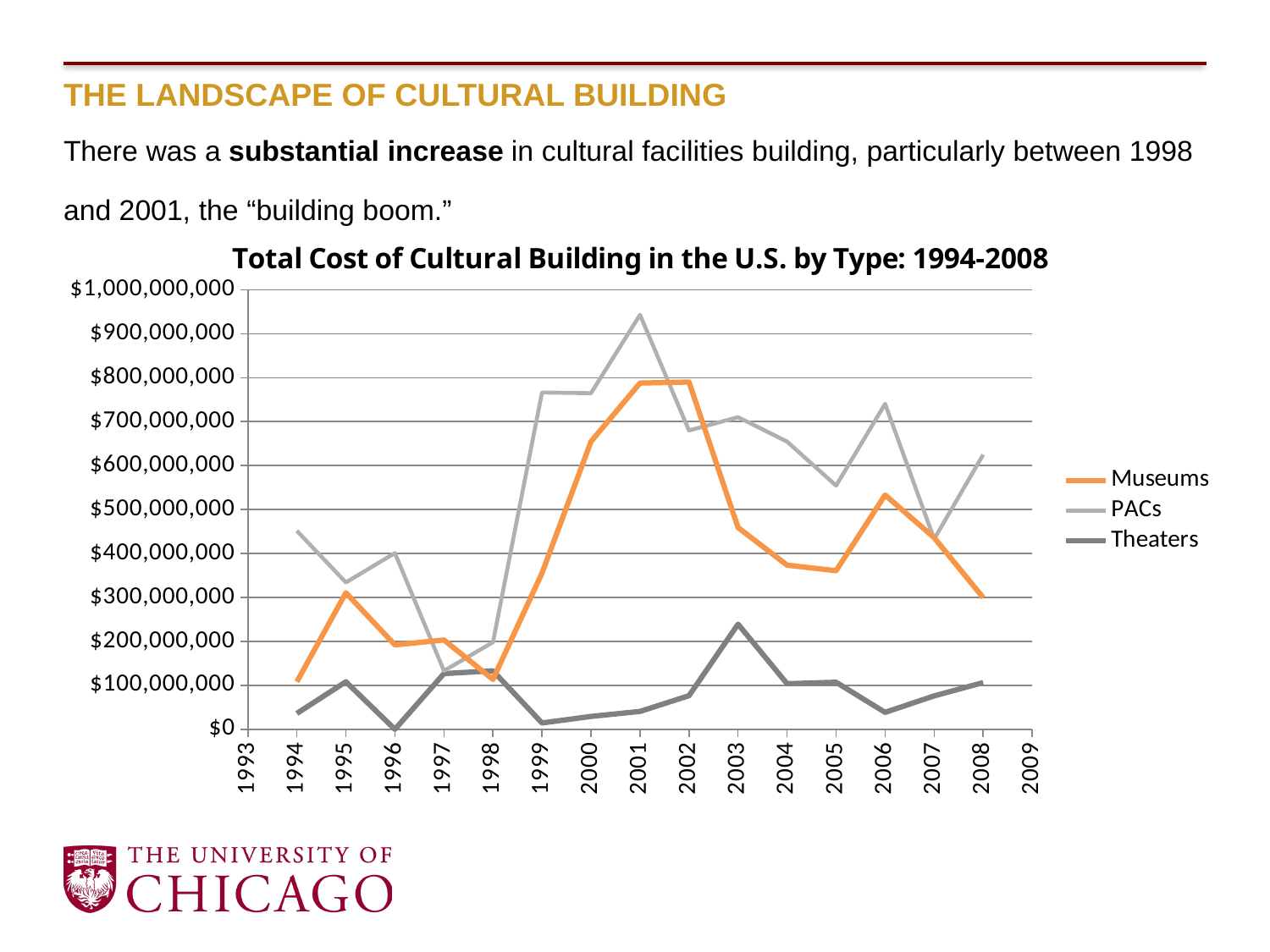
What is the title of the chart? Total Cost of Cultural Building in the U.S. by Type: 1994-2008 What kind of chart is shown on the slide? Line chart Which series has the larger value in 2001, PACs or Museums? PACs In which year does the Theaters series reach its highest value? 2003 Is the value for Museums in 2001 greater or less than $700,000,000? greater Is the value for PACs in 2001 greater or less than $900,000,000? greater In which year does the PACs series reach its highest value? 2001 Is the value for Theaters in 1996 greater or less than $100,000,000? less Do the Museums values rise or fall from 1998 to 2001? Rise How many series does the legend list? 3 Which series is drawn in orange? Museums Which series has the larger value in 2003, Museums or Theaters? Museums